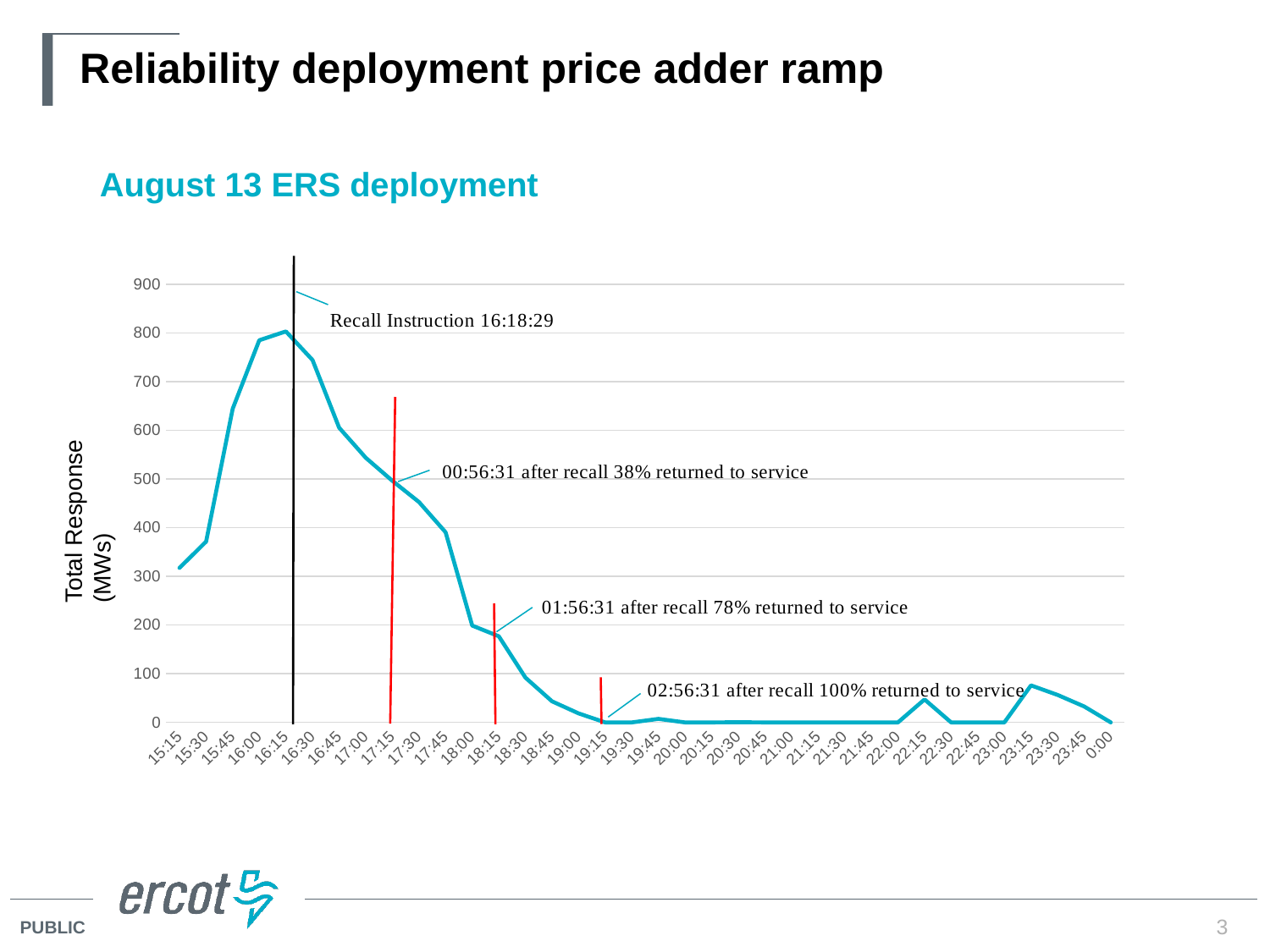
Does the Total Response rise or fall between 16:15 and 19:15? fall Which is larger, the Total Response at 16:00 or at 17:00? 16:00 How many time points are labelled on the x axis of the chart? 36 Is the Total Response at 16:00 greater or less than 700? greater At which time does the Total Response reach its highest value? 16:15 Is the Total Response at 17:45 greater or less than 500? less What is the title of the chart? August 13 ERS deployment What time is given for the Recall Instruction in the chart annotation? 16:18:29 What kind of chart is shown on the slide? line chart Is the Total Response at 17:15 greater or less than 600? less